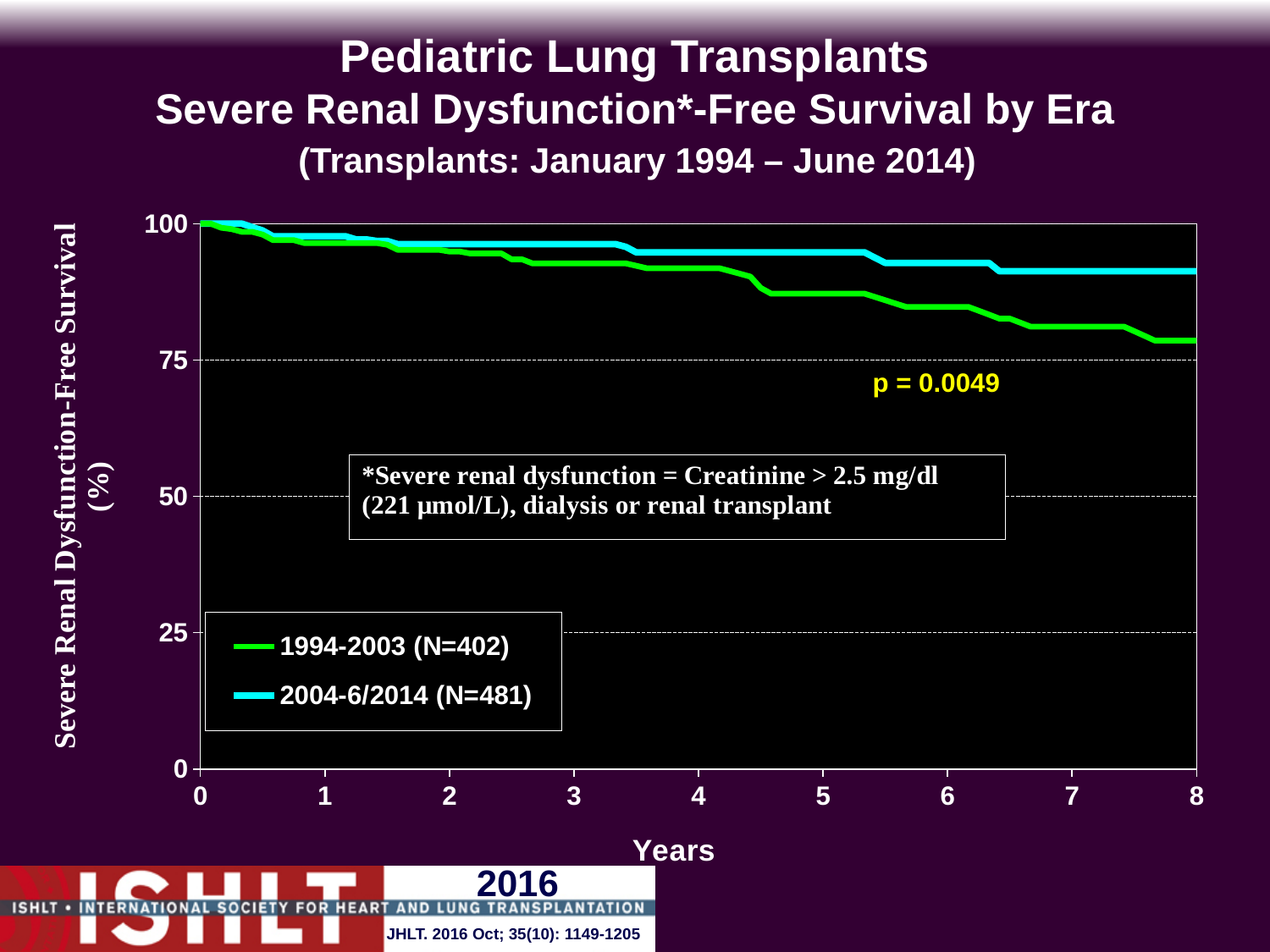
Is the value for the 2004-6/2014 era at 6 years greater or less than 50? greater Which era has the higher severe renal dysfunction-free survival at 8 years, 1994-2003 or 2004-6/2014? 2004-6/2014 Which era's curve is higher across the whole chart? 2004-6/2014 How many series does the legend list? 2 Is the value for the 2004-6/2014 era at 8 years greater or less than 75? greater Is the value for the 1994-2003 era at 4 years greater or less than 75? greater Which two eras are listed in the legend? 1994-2003 and 2004-6/2014 Which era's curve is lower across the whole chart? 1994-2003 Do the survival curves rise or fall as years increase? fall What kind of chart is shown on the slide? line chart What p-value is printed on the chart? p = 0.0049